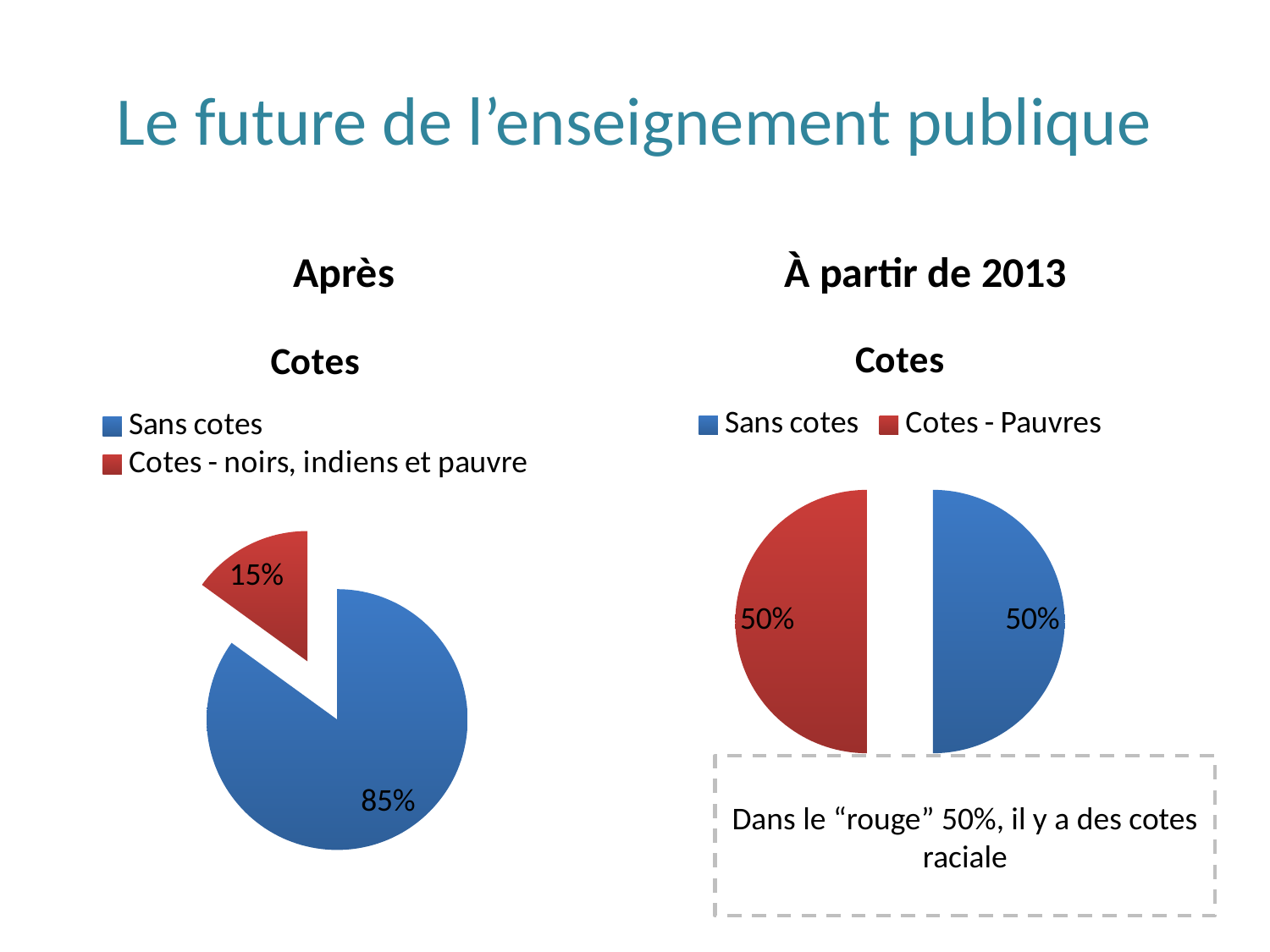
In the left pie chart (under "Après"), what share does "Cotes - noirs, indiens et pauvre" have? 15% In the left pie chart (under "Après"), which slice is the smallest? Cotes - noirs, indiens et pauvre What kind of chart is shown under "À partir de 2013"? Pie chart In the right pie chart (under "À partir de 2013"), what share does "Cotes - Pauvres" have? 50% In the left pie chart (under "Après"), what is the difference between the "Sans cotes" share and the "Cotes - noirs, indiens et pauvre" share? 70% In the left pie chart (under "Après"), which is larger: "Sans cotes" or "Cotes - noirs, indiens et pauvre"? Sans cotes What is the title of the left pie chart (under "Après")? Cotes How many entries does the legend of the left pie chart (under "Après") list? 2 In the left pie chart (under "Après"), what share does "Sans cotes" have? 85% In the left pie chart (under "Après"), which slice is the largest? Sans cotes How many slices does the right pie chart (under "À partir de 2013") have? 2